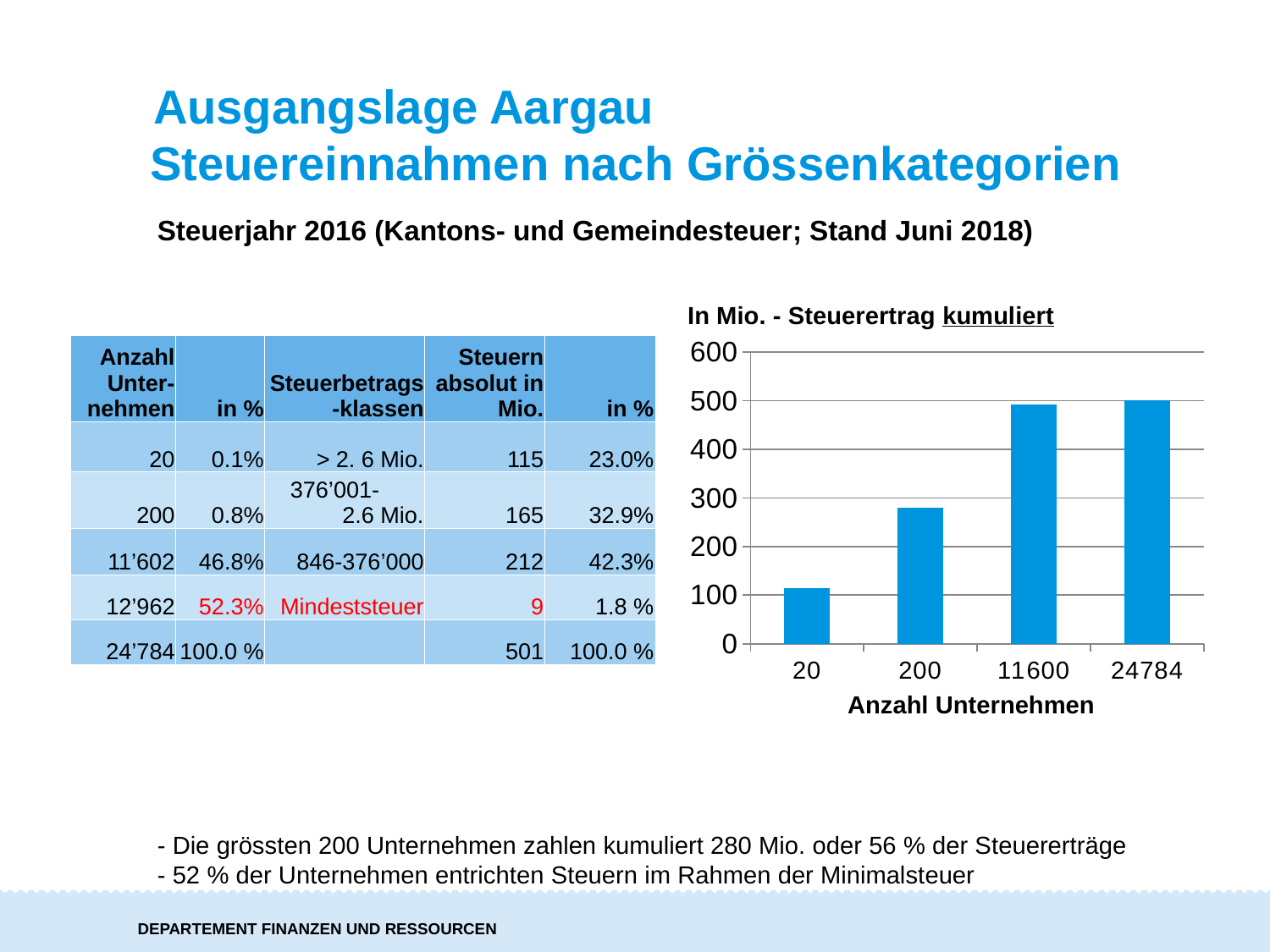
Is the value for 11600 greater or less than 400? greater What is the label of the x axis of the chart? Anzahl Unternehmen Is the value for 200 greater or less than 300? less Which category has the lowest bar in the chart? 20 What kind of chart is shown on the slide? bar chart Do the bar values rise or fall from left to right along the x axis? rise Is the value for 20 greater or less than 100? greater Which is larger, the value for 200 or the value for 11600? 11600 What is the title of the chart? In Mio. - Steuerertrag kumuliert How many bars does the chart show? 4